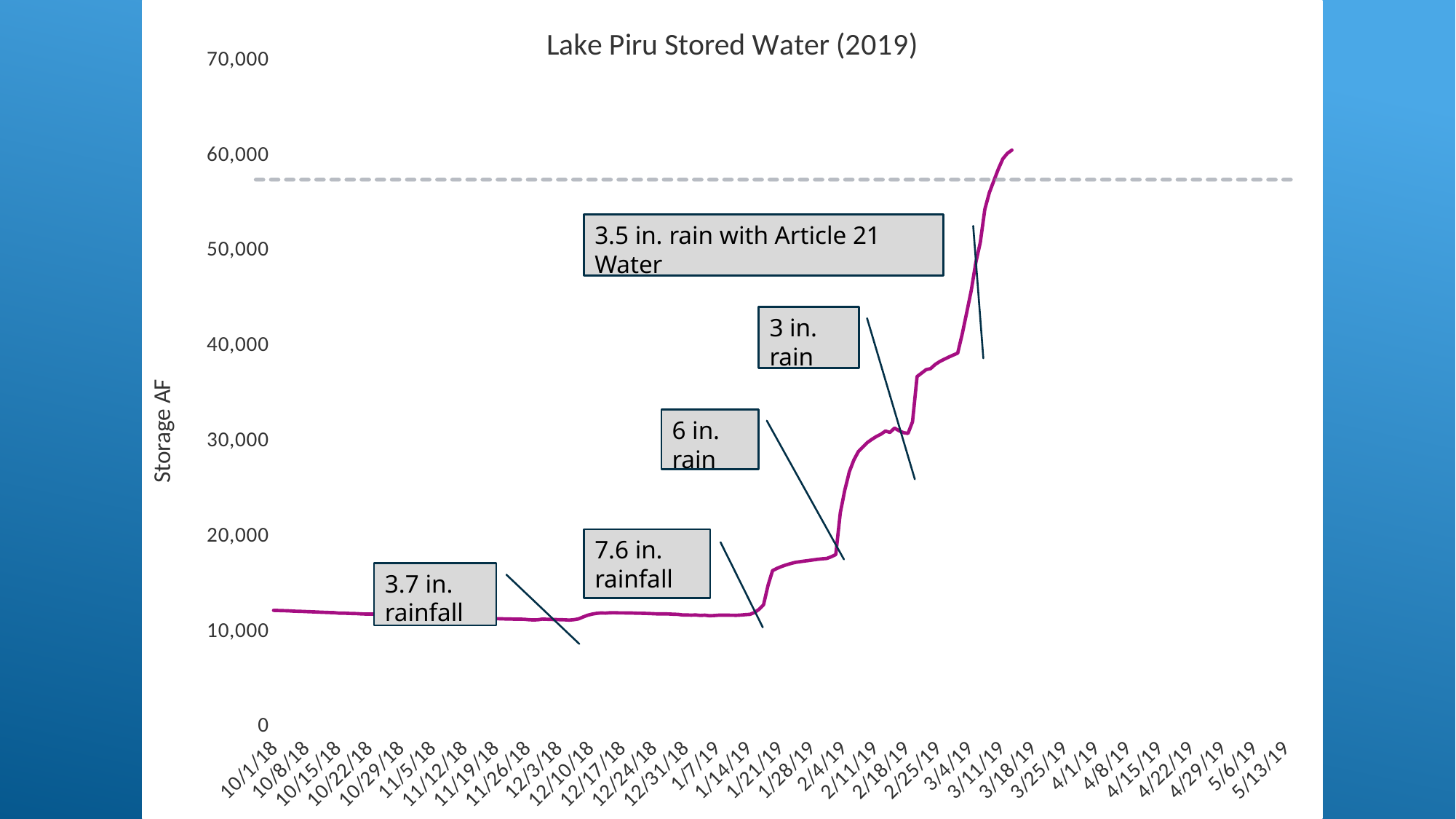
Is the stored water value at 2/18/19 greater or less than 40,000? less Which date has the higher stored water value, 12/3/18 or 3/4/19? 3/4/19 What is the title of the chart? Lake Piru Stored Water (2019) How many rainfall annotation boxes are shown on the chart? 5 Does the stored water value generally rise or fall from 10/1/18 to 3/11/19? rise What kind of chart is shown on the slide? line chart Is the stored water value at 2/18/19 greater or less than 20,000? greater Is the stored water value at 12/31/18 greater or less than 20,000? less What is the label on the vertical axis of the chart? Storage AF